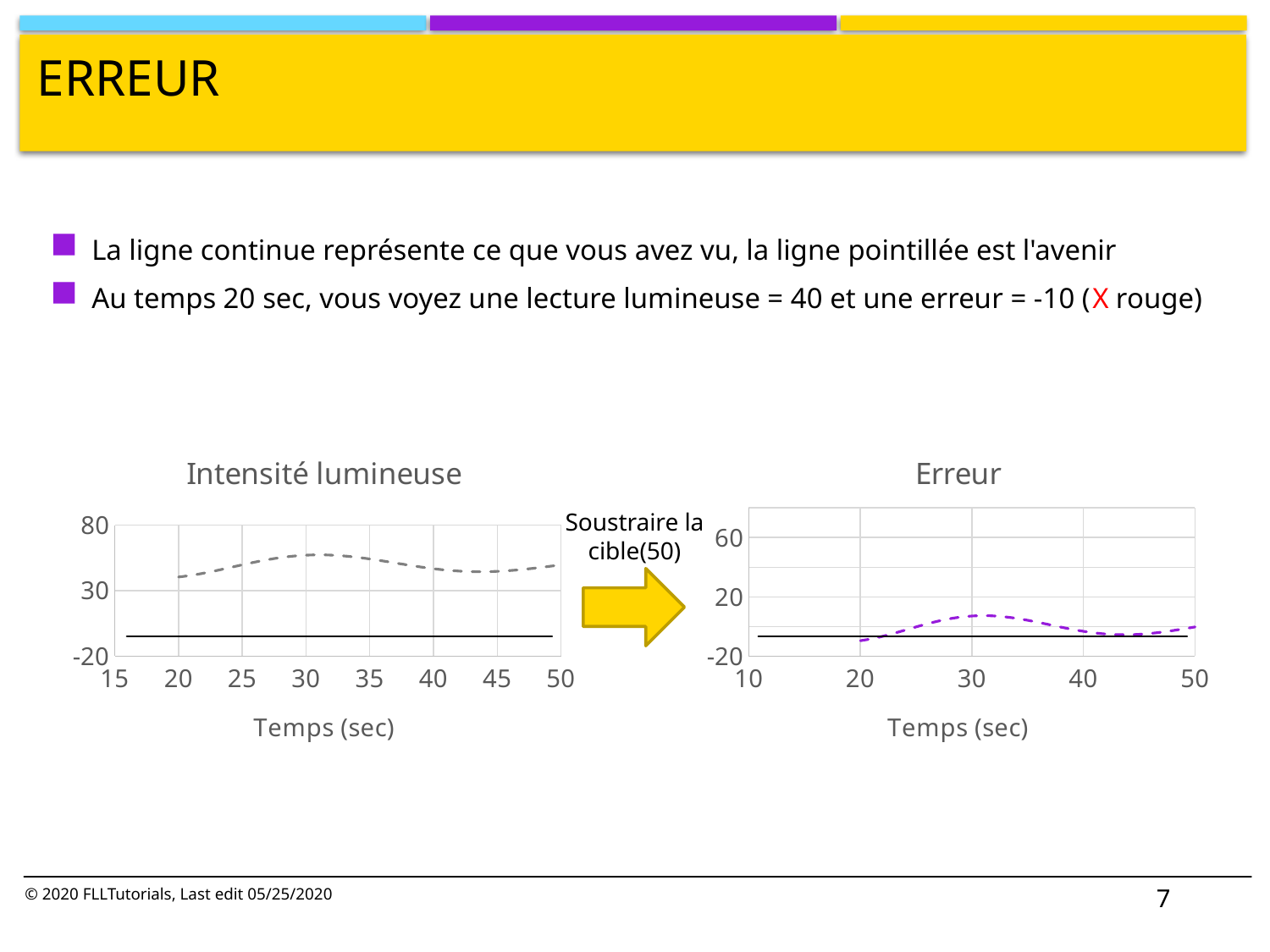
In the 'Erreur' chart, is the value of the dashed line at 20 sec greater or less than 20? less How many charts are shown on the slide? 2 What is the title of the chart on the right side of the slide? Erreur In the 'Intensité lumineuse' chart, does the dashed line rise or fall between 20 sec and 30 sec? rise In the 'Intensité lumineuse' chart, is the value of the dashed line at 30 sec greater or less than 30? greater What kind of chart is the 'Intensité lumineuse' chart? line chart In the 'Intensité lumineuse' chart, at which x-axis tick does the dashed line reach its highest value? 30 In the 'Intensité lumineuse' chart, is the value of the dashed line at 20 sec greater or less than 80? less In the 'Erreur' chart, does the dashed line rise or fall between 20 sec and 30 sec? rise What is the x-axis label of the 'Intensité lumineuse' chart? Temps (sec) What kind of chart is the 'Erreur' chart? line chart